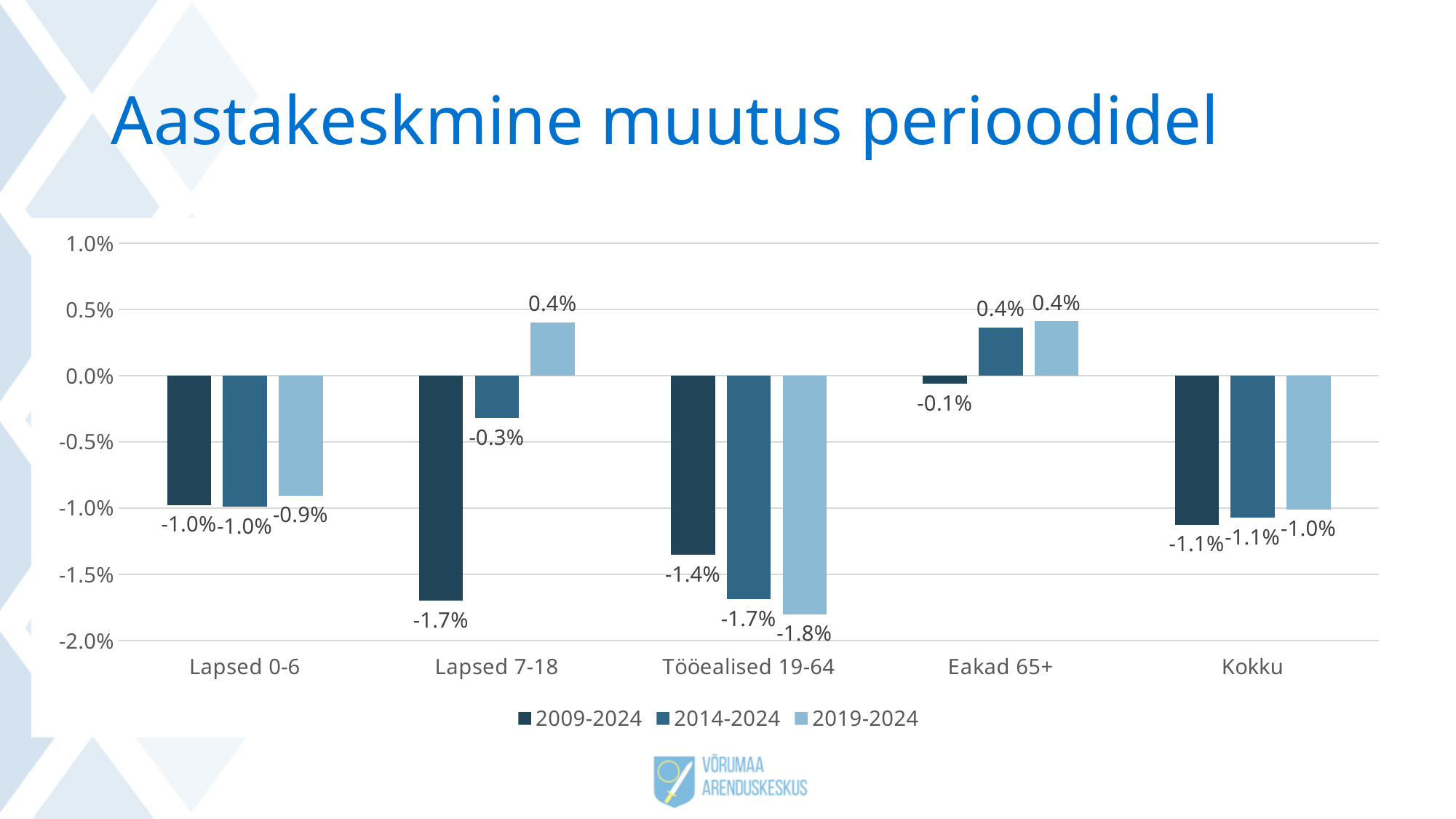
What is the value for Lapsed 7-18 in the 2014-2024 series? -0.3% Which category has the highest value in the 2009-2024 series? Eakad 65+ What is the value for Eakad 65+ in the 2009-2024 series? -0.1% What is the difference between the 2009-2024 and 2014-2024 values for Lapsed 7-18? 1.4 percentage points How many categories are shown on the x axis? 5 What kind of chart is shown on the slide? Bar chart Which is larger: the 2014-2024 value for Lapsed 0-6 or the 2014-2024 value for Tööealised 19-64? Lapsed 0-6 What is the value for Lapsed 7-18 in the 2019-2024 series? 0.4% Which category has the lowest value in the 2019-2024 series? Tööealised 19-64 How many series does the legend list? 3 What is the value for Tööealised 19-64 in the 2009-2024 series? -1.4% What is the title of the slide? Aastakeskmine muutus perioodidel